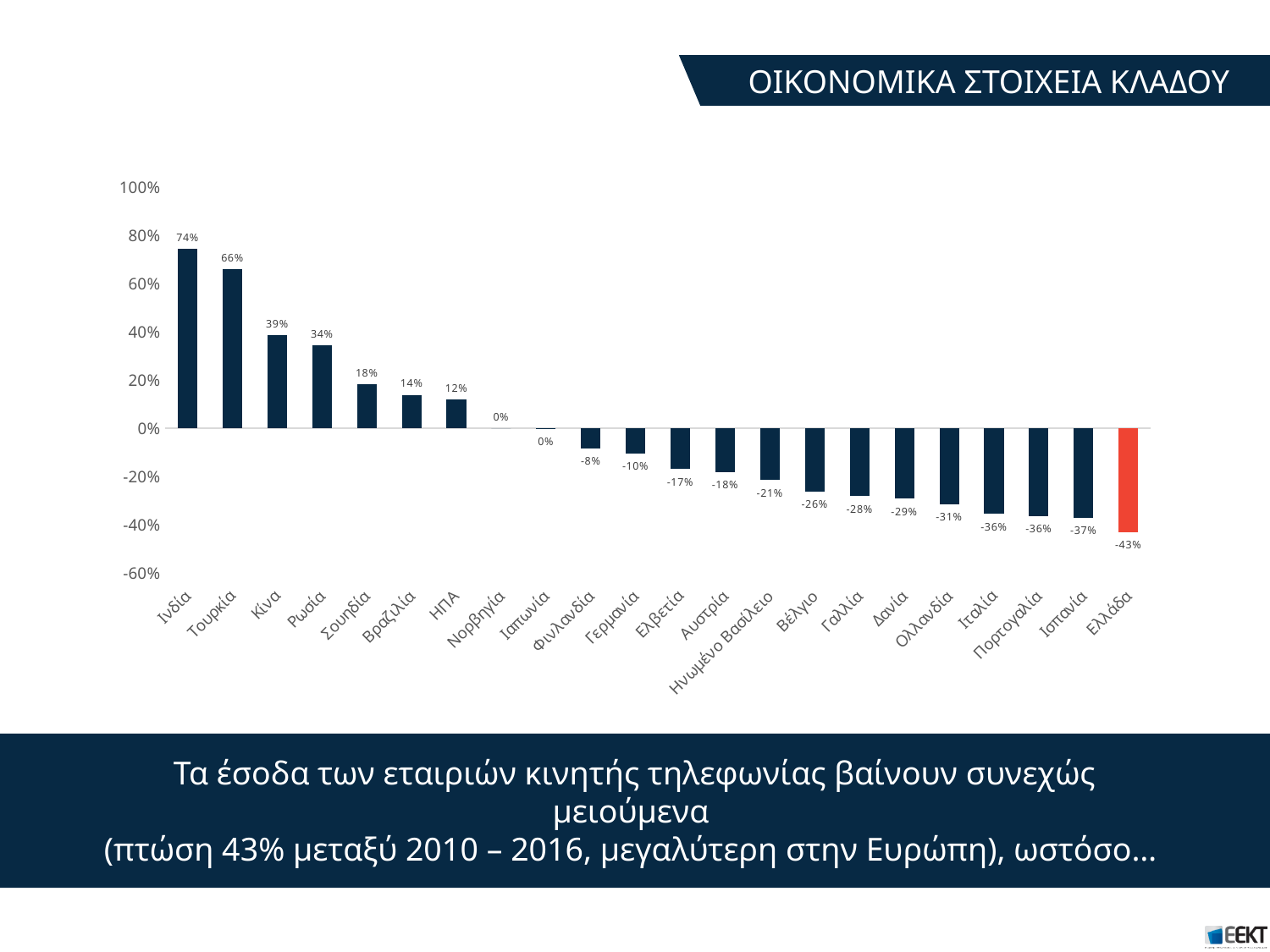
Which bar is highlighted in a different colour (red/orange) from the others? Ελλάδα Which country has the lowest value in the chart? Ελλάδα What kind of chart is shown on the slide? Bar chart Which country has the highest value in the chart? Ινδία What is the value shown for Ηνωμένο Βασίλειο? -21% What is the value shown for Ελλάδα? -43% Do the values rise or fall moving from left to right along the x axis? Fall What is the value shown for Γερμανία? -10% What is the difference between the values for Ινδία and Τουρκία? 8% How many countries are shown on the x axis of the chart? 22 What is the value shown for Ινδία? 74% Which has a larger value, Κίνα or Ρωσία? Κίνα